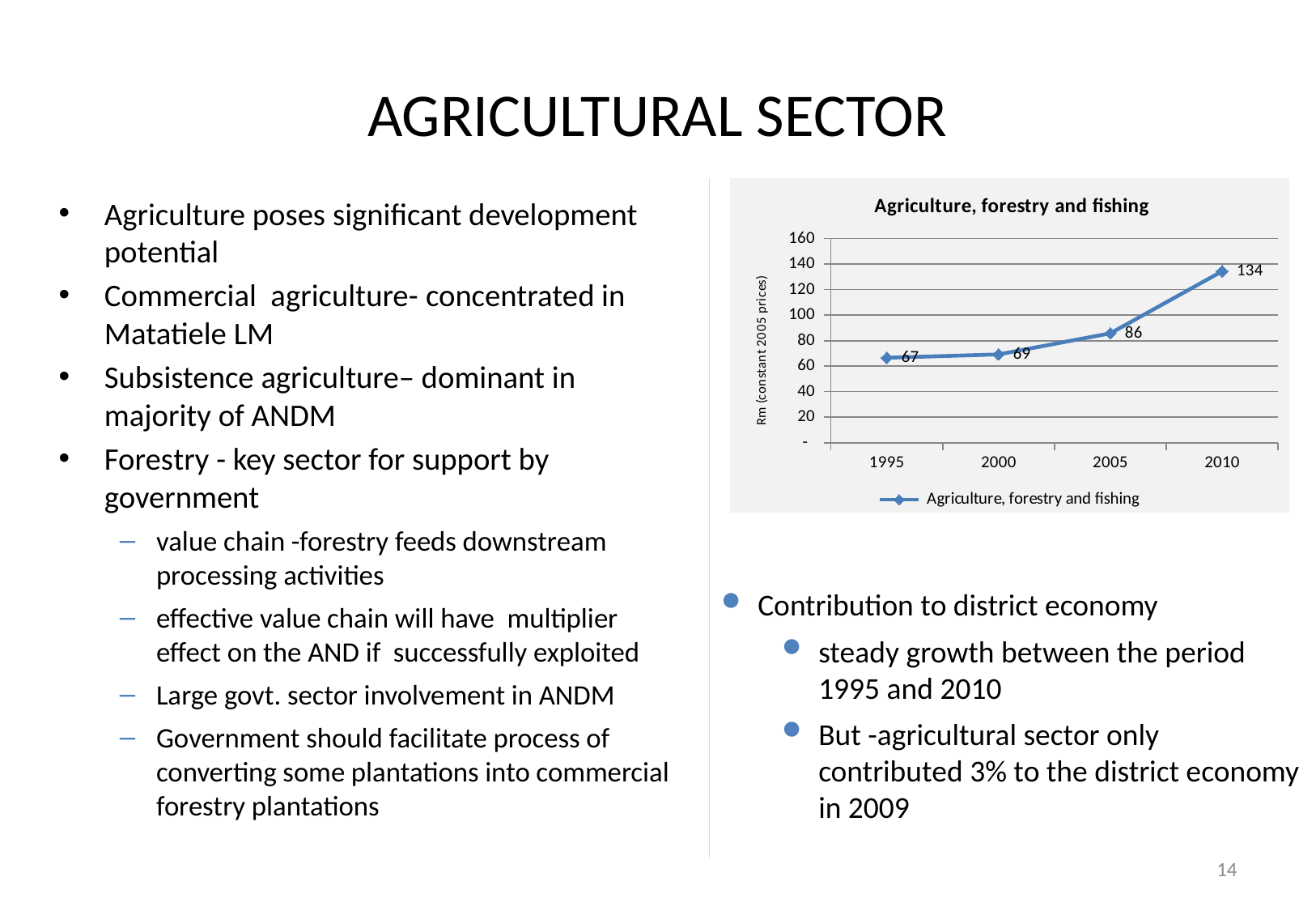
What is the value for 2010 in the Agriculture, forestry and fishing chart? 134 What is the value for 2000 in the Agriculture, forestry and fishing chart? 69 Do the values in the Agriculture, forestry and fishing chart rise or fall from 1995 to 2010? Rise What kind of chart is the Agriculture, forestry and fishing chart? Line chart What is the y-axis label of the Agriculture, forestry and fishing chart? Rm (constant 2005 prices) What is the value for 2005 in the Agriculture, forestry and fishing chart? 86 Which year has the lowest value in the Agriculture, forestry and fishing chart? 1995 What is the difference between the 2010 and 2005 values in the Agriculture, forestry and fishing chart? 48 Which year has the highest value in the Agriculture, forestry and fishing chart? 2010 What is the value for 1995 in the Agriculture, forestry and fishing chart? 67 How many data points are plotted in the Agriculture, forestry and fishing chart? 4 Which is larger in the Agriculture, forestry and fishing chart, the value for 2005 or the value for 2000? 2005